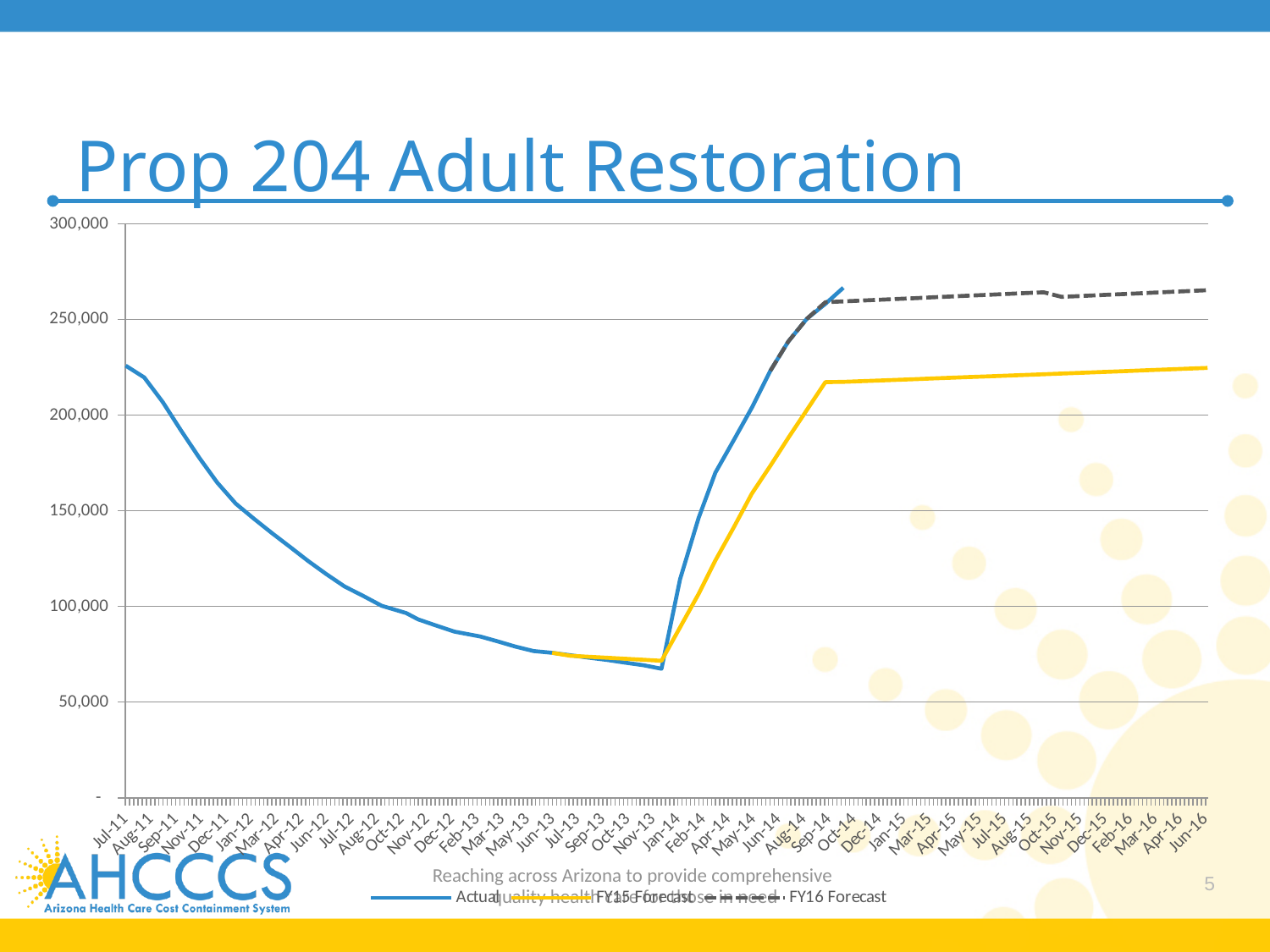
At Jun-16, which is higher: the FY15 Forecast or the FY16 Forecast? FY16 Forecast What kind of chart is shown on the slide? Line chart Does the Actual series rise or fall from Jul-11 to Nov-13? Fall Is the Actual value at Nov-13 greater or less than 100,000? less Is the FY15 Forecast value at Jun-16 greater or less than 250,000? less Which is larger: the Actual value at Jul-11 or the Actual value at Nov-13? Jul-11 Is the Actual value at Jul-11 greater or less than 200,000? greater What is the title of the chart on the slide? Prop 204 Adult Restoration Does the Actual series rise or fall from Dec-13 to Oct-14? Rise How many series does the chart legend list? 3 Which series is drawn as a dashed line? FY16 Forecast